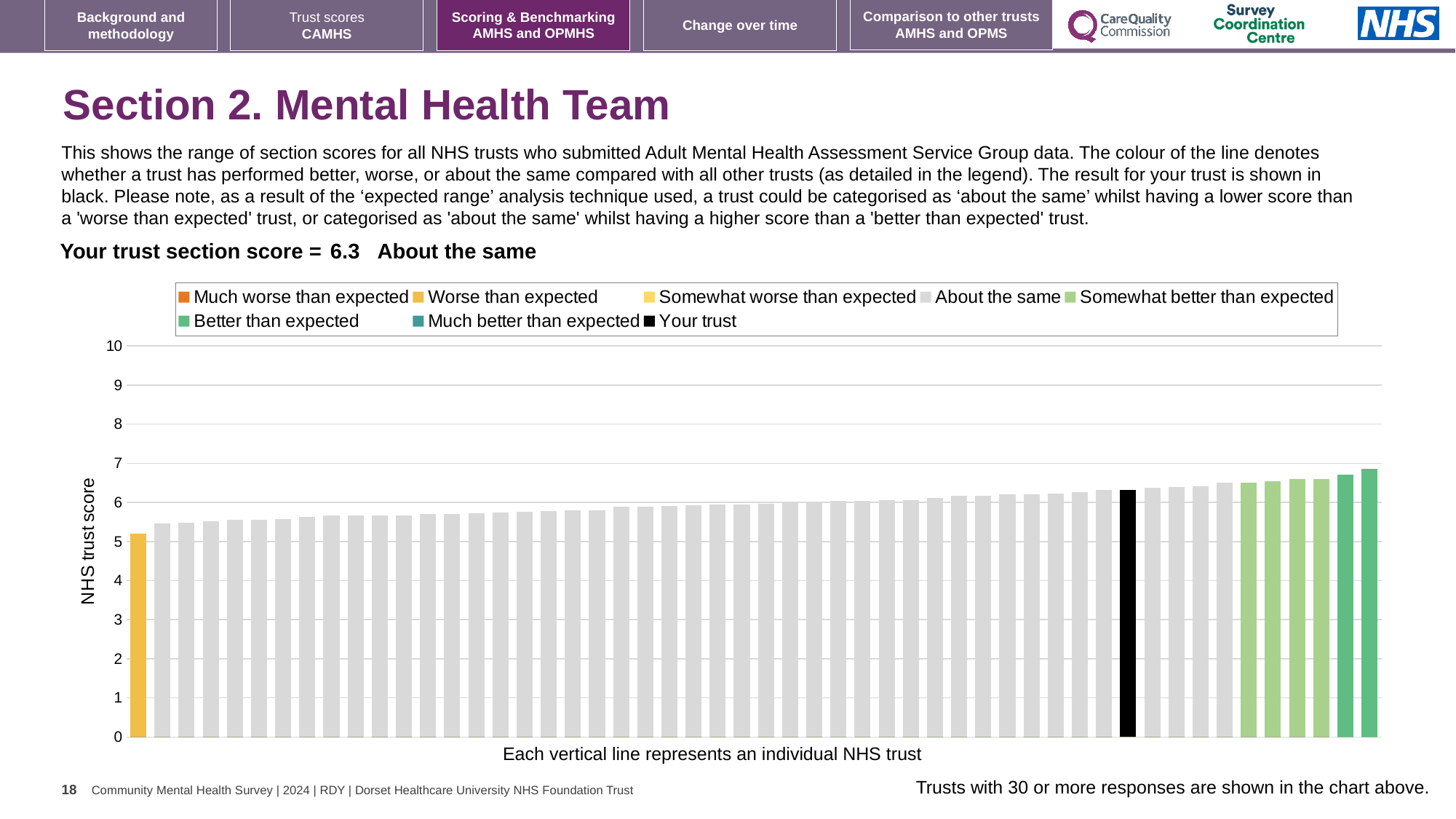
How many entries does the chart legend list? 8 Is the value of the lowest bar in the chart greater or less than 6? less Is the value for your trust (the black bar) greater or less than 6? greater Which category is your trust placed in for this section? About the same Is the value of the lowest bar in the chart greater or less than 5? greater Do the bar values rise or fall from left to right across the chart? rise What kind of chart is shown on the slide? bar chart What is the section score for your trust? 6.3 What is the highest value shown on the vertical axis? 10 What is the label on the vertical axis of the chart? NHS trust score What colour is the bar representing your trust? black